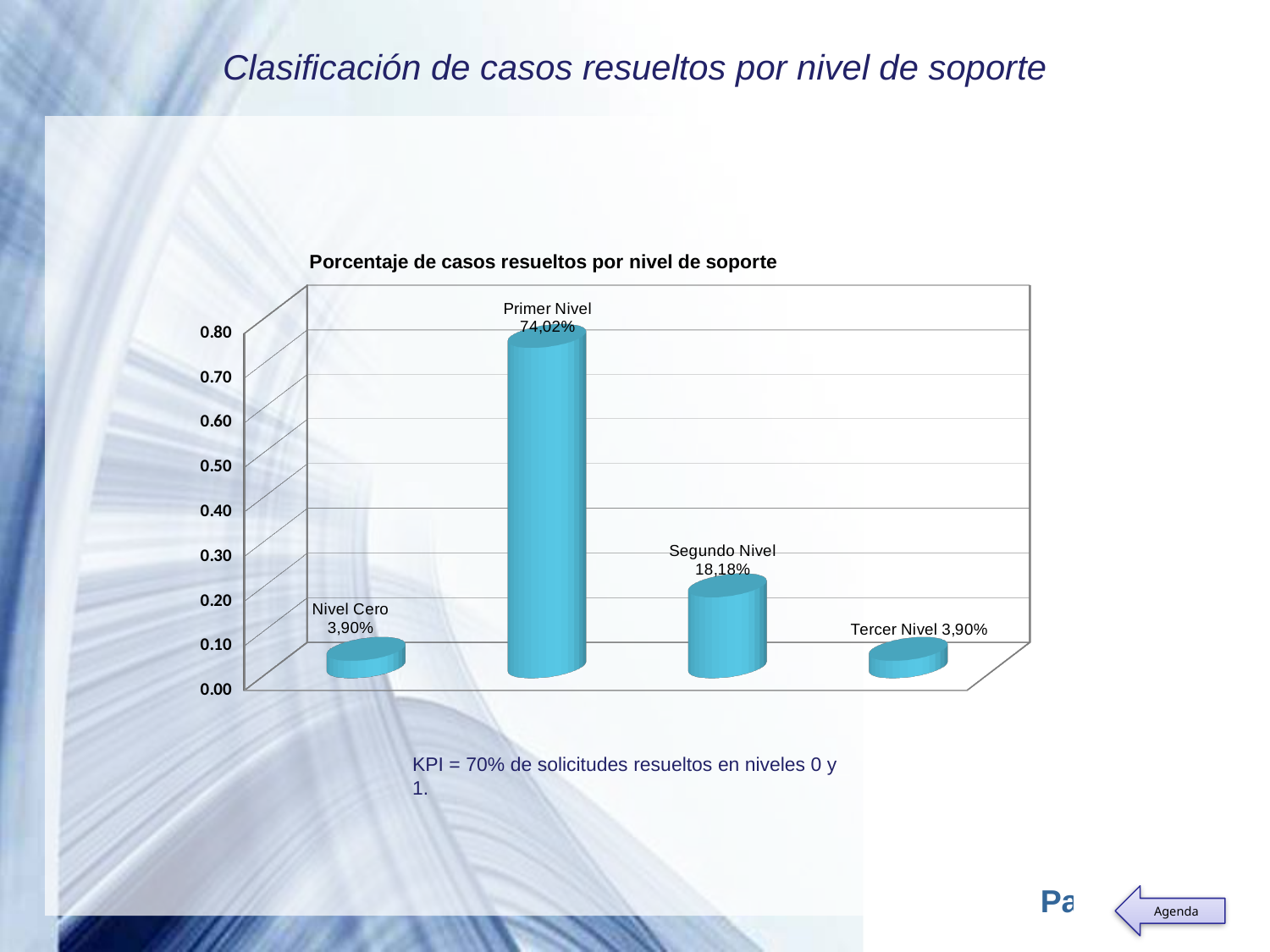
What is the title of the chart? Porcentaje de casos resueltos por nivel de soporte What is the difference between the values for Primer Nivel and Segundo Nivel? 55,84% Which is larger, the value for Segundo Nivel or the value for Nivel Cero? Segundo Nivel Is the value for Primer Nivel greater or less than 0.70? greater What kind of chart is shown on the slide? Bar chart How many support levels are shown in the chart? 4 What is the value for Tercer Nivel? 3,90% What is the value for Nivel Cero? 3,90% What is the value for Segundo Nivel? 18,18% What is the value for Primer Nivel? 74,02% Is the value for Segundo Nivel greater or less than 0.30? less Which support level has the highest percentage of resolved cases? Primer Nivel